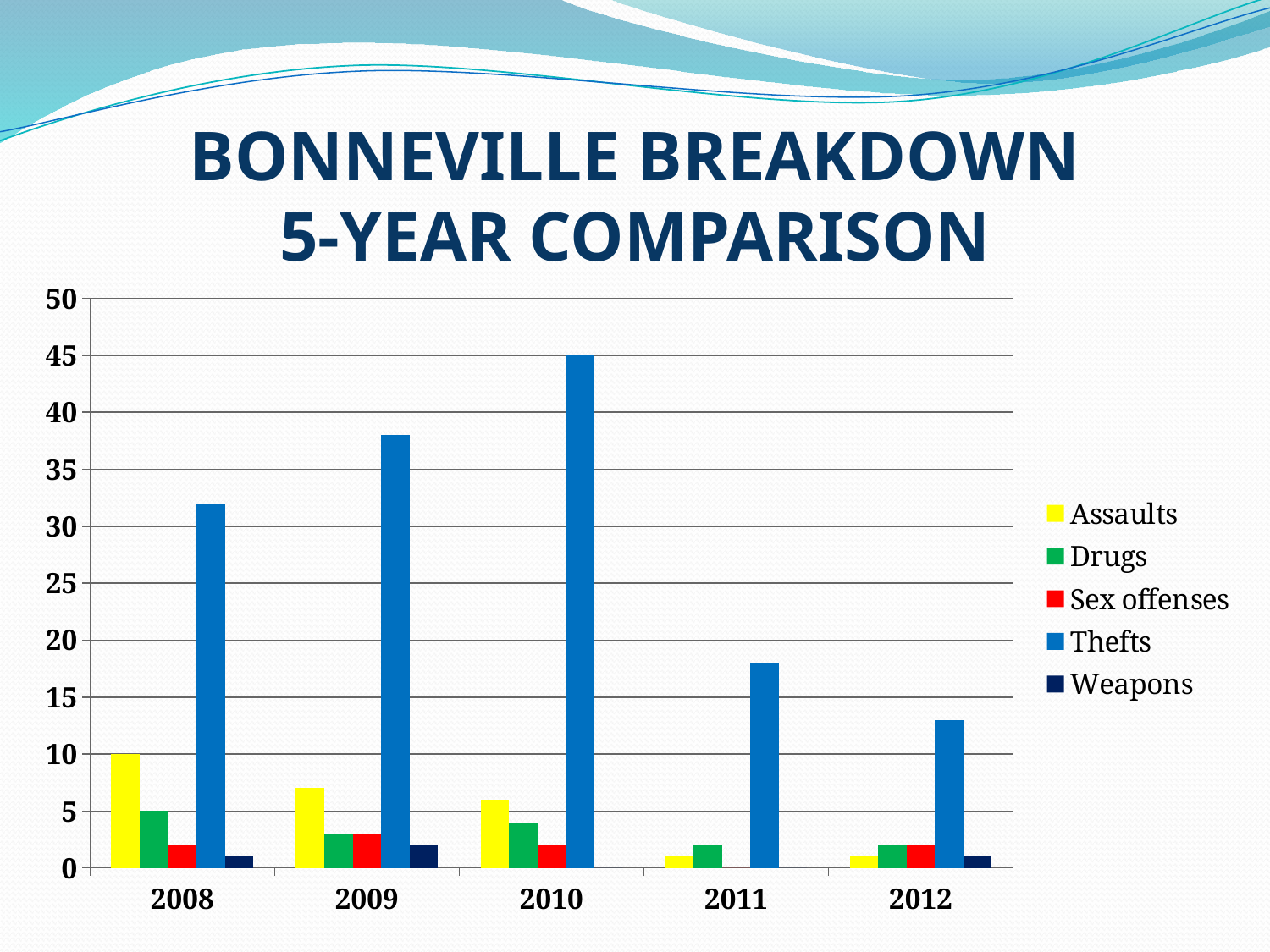
What is the value for Thefts in 2010? 45 In which year is the Thefts value lowest? 2012 Do the Thefts values rise or fall from 2010 to 2012? fall What is the value for Assaults in 2008? 10 How many series does the legend list? 5 How many years are shown on the x axis? 5 Which series is shown in yellow in the legend? Assaults In which year is the Thefts value highest? 2010 Is the value for Thefts in 2011 greater or less than 20? less Is the value for Thefts in 2009 greater or less than 35? greater Which is larger, Thefts in 2008 or Thefts in 2011? Thefts in 2008 What type of chart is shown on the slide? bar chart